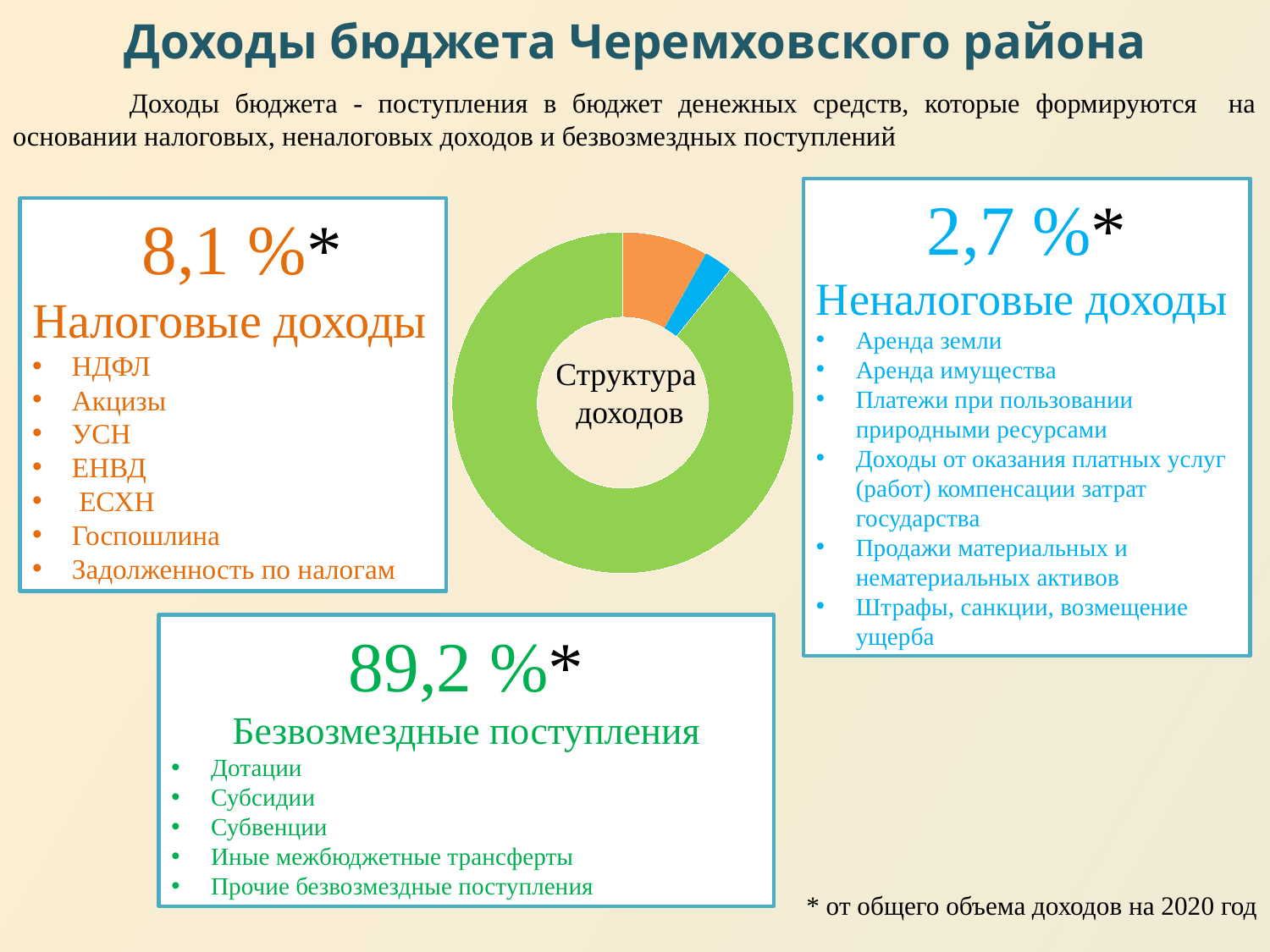
Which income category has the largest slice in the donut chart? Безвозмездные поступления Which income category has the smallest slice in the donut chart? Неналоговые доходы What kind of chart is shown in the centre of the slide? Pie (donut) chart What colour is the slice representing Неналоговые доходы in the donut chart? Blue What is the title shown in the centre of the donut chart? Структура доходов How many slices does the donut chart have? 3 What is the difference in percentage points between the share of Налоговые доходы and the share of Неналоговые доходы? 5,4 What share of total income do Неналоговые доходы make up? 2,7 % What share of total income do Налоговые доходы make up? 8,1 % Which is larger: the share of Налоговые доходы or the share of Неналоговые доходы? Налоговые доходы What share of total income do Безвозмездные поступления make up? 89,2 % What is the difference in percentage points between the share of Безвозмездные поступления and the share of Налоговые доходы? 81,1